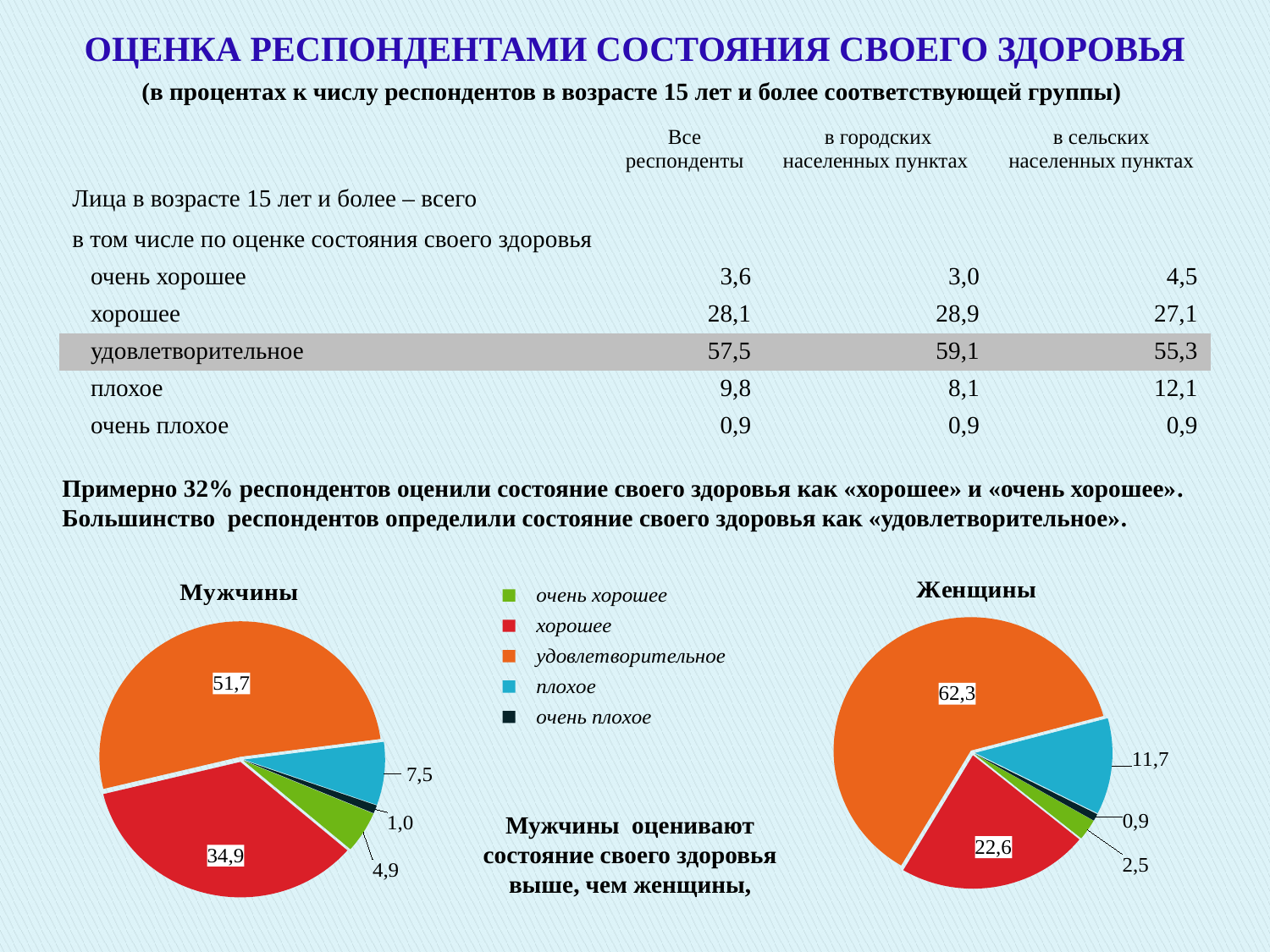
In the "Женщины" pie chart, which category has the largest slice? удовлетворительное What is the difference between the "удовлетворительное" value in the "Женщины" chart and the "удовлетворительное" value in the "Мужчины" chart? 10,6 In the "Мужчины" pie chart, what is the difference between the "удовлетворительное" and "хорошее" values? 16,8 What type of chart is the "Женщины" chart? pie chart In the "Мужчины" pie chart, what is the value for "очень хорошее"? 4,9 In the legend for the pie charts, which colour represents "плохое"? light blue In the "Мужчины" pie chart, what is the value for "удовлетворительное"? 51,7 In the "Женщины" pie chart, what is the value for "хорошее"? 22,6 In the "Мужчины" pie chart, which category has the smallest slice? очень плохое How many categories does the legend shared by the two pie charts list? 5 In the "Женщины" pie chart, what is the value for "плохое"? 11,7 Which chart has the larger value for "хорошее", "Мужчины" or "Женщины"? Мужчины